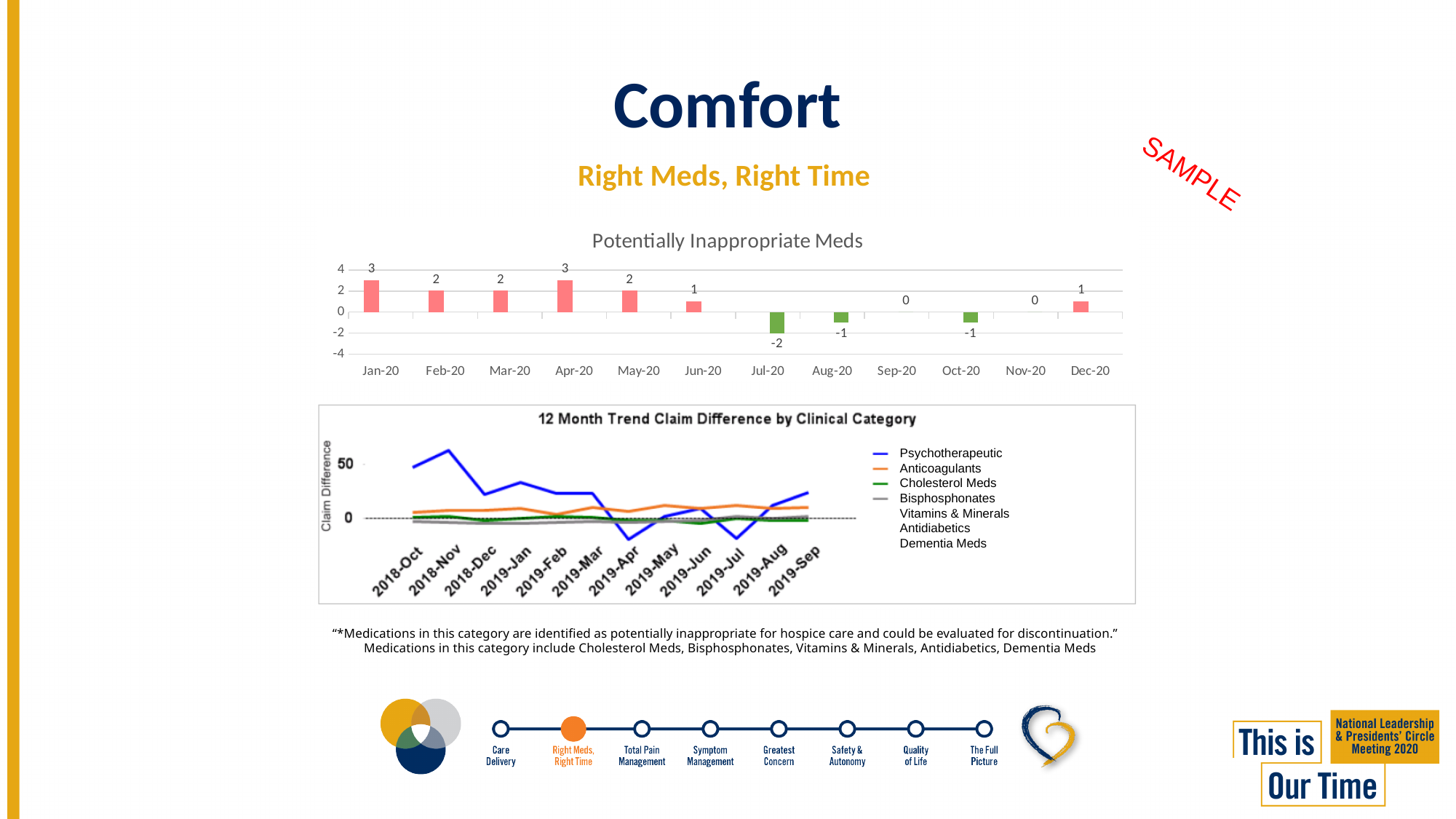
In the 'Potentially Inappropriate Meds' chart, which is larger, the value for Feb-20 or the value for Aug-20? Feb-20 How many months are shown on the x axis of the 'Potentially Inappropriate Meds' chart? 12 What kind of chart is the 'Potentially Inappropriate Meds' chart? Bar chart In the 'Potentially Inappropriate Meds' chart, what is the value for Jan-20? 3 In the 'Potentially Inappropriate Meds' chart, do the values generally rise or fall from Jan-20 to Oct-20? Fall In the 'Potentially Inappropriate Meds' chart, what is the value for Dec-20? 1 In the 'Potentially Inappropriate Meds' chart, what is the difference between the values for Apr-20 and Jun-20? 2 How many series does the legend of the '12 Month Trend Claim Difference by Clinical Category' chart list? 7 In the 'Potentially Inappropriate Meds' chart, what is the value for Jul-20? -2 In the 'Potentially Inappropriate Meds' chart, which month has the lowest value? Jul-20 In the '12 Month Trend Claim Difference by Clinical Category' chart, is the Psychotherapeutic value for 2018-Nov greater or less than 50? greater What kind of chart is the '12 Month Trend Claim Difference by Clinical Category' chart? Line chart